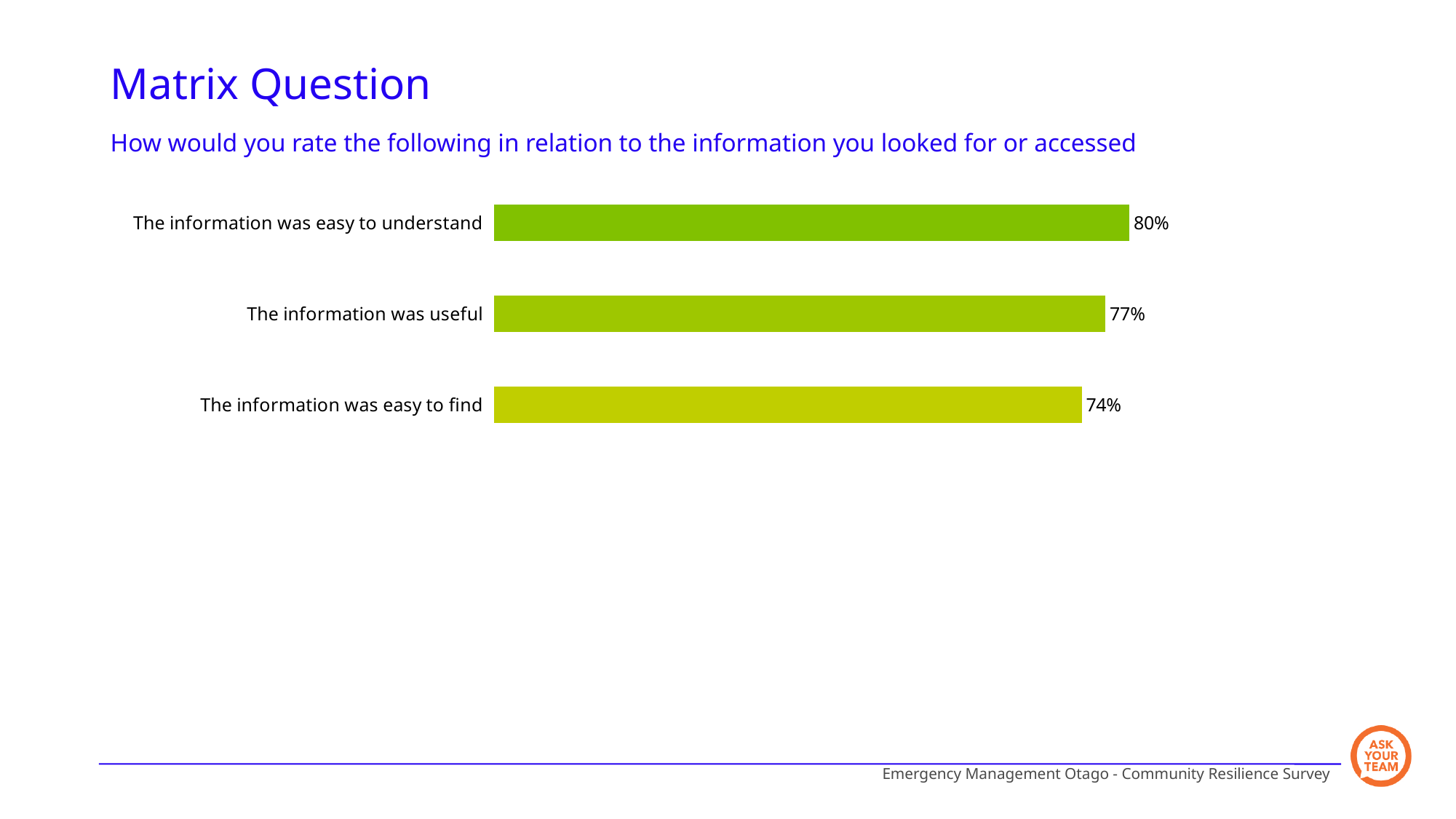
Which statement has the highest percentage? The information was easy to understand What percentage is shown for "The information was useful"? 77% What percentage is shown for "The information was easy to find"? 74% Which statement has the lowest percentage? The information was easy to find What question does the chart relate to, as stated in the subtitle? How would you rate the following in relation to the information you looked for or accessed What is the difference in percentage points between "The information was useful" and "The information was easy to find"? 3 What type of chart is shown on the slide? Bar chart Which has a higher percentage: "The information was useful" or "The information was easy to find"? The information was useful What is the difference in percentage points between "The information was easy to understand" and "The information was easy to find"? 6 What is the title of the slide? Matrix Question What percentage is shown for "The information was easy to understand"? 80% How many statements are rated in the chart? 3